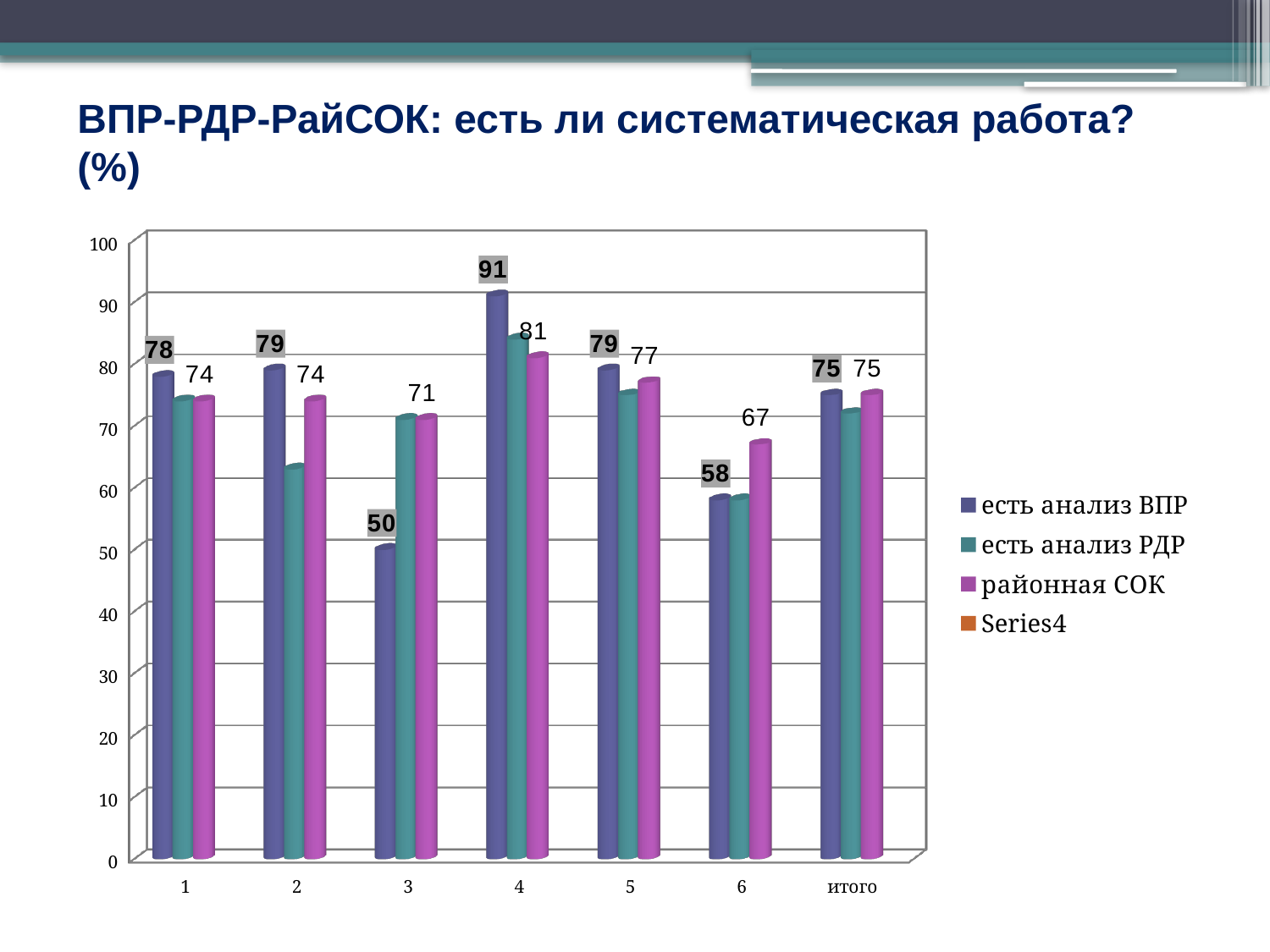
What is the value of the "есть анализ ВПР" series for category 4? 91 How many series does the legend list? 4 For category 3, what is the difference between the "районная СОК" value and the "есть анализ ВПР" value? 21 How many categories are shown on the x axis of the chart? 7 What is the value of the "районная СОК" series for "итого"? 75 Is the value of the "есть анализ РДР" series for category 2 greater or less than 70? less Which category has the lowest value for the "есть анализ ВПР" series? 3 Which category has the highest value for the "есть анализ ВПР" series? 4 What kind of chart is shown on the slide? bar chart Is the value of the "есть анализ РДР" series for category 4 greater or less than 80? greater For category 2, which series has the larger value: "есть анализ ВПР" or "районная СОК"? есть анализ ВПР What is the value of the "районная СОК" series for category 6? 67